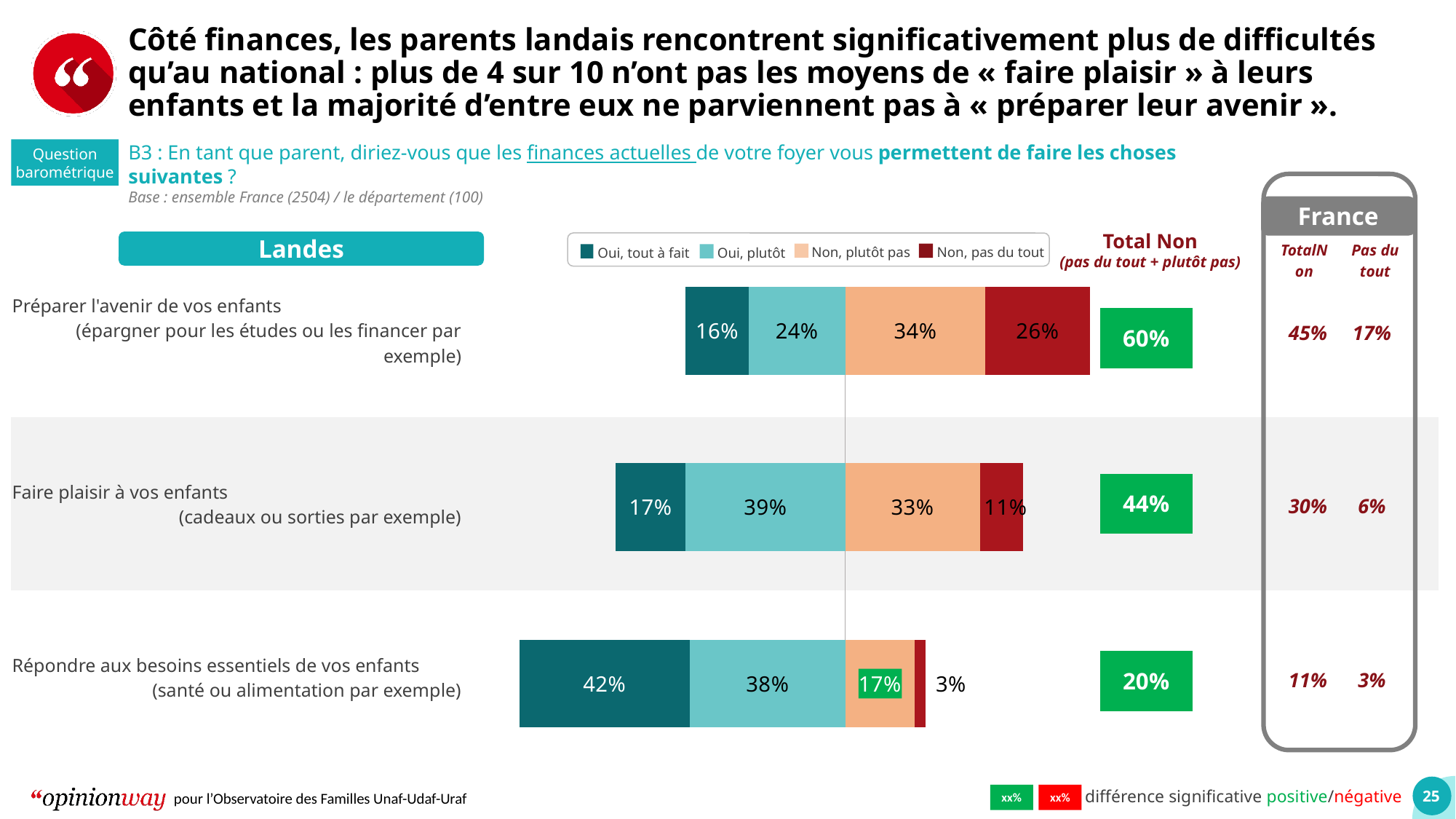
What is the combined "Oui, tout à fait" and "Oui, plutôt" total for "Répondre aux besoins essentiels de vos enfants"? 80% What percentage of Landes parents answered "Oui, tout à fait" for "Répondre aux besoins essentiels de vos enfants"? 42% What is the "Oui, plutôt" value for "Faire plaisir à vos enfants"? 39% Which is larger: the "Non, plutôt pas" value for "Préparer l'avenir de vos enfants" or for "Faire plaisir à vos enfants"? Préparer l'avenir de vos enfants What is the difference between the "Oui, tout à fait" values for "Répondre aux besoins essentiels de vos enfants" and "Faire plaisir à vos enfants"? 25 percentage points What kind of chart is used on this slide? Stacked bar chart Which item has the lowest "Non, pas du tout" value? Répondre aux besoins essentiels de vos enfants Which item has the highest Total Non value? Préparer l'avenir de vos enfants What is the "Non, pas du tout" value for "Préparer l'avenir de vos enfants"? 26% How many items (categories) are shown in the bar chart? 3 What is the Total Non value shown for "Faire plaisir à vos enfants"? 44% How many series does the legend list? 4